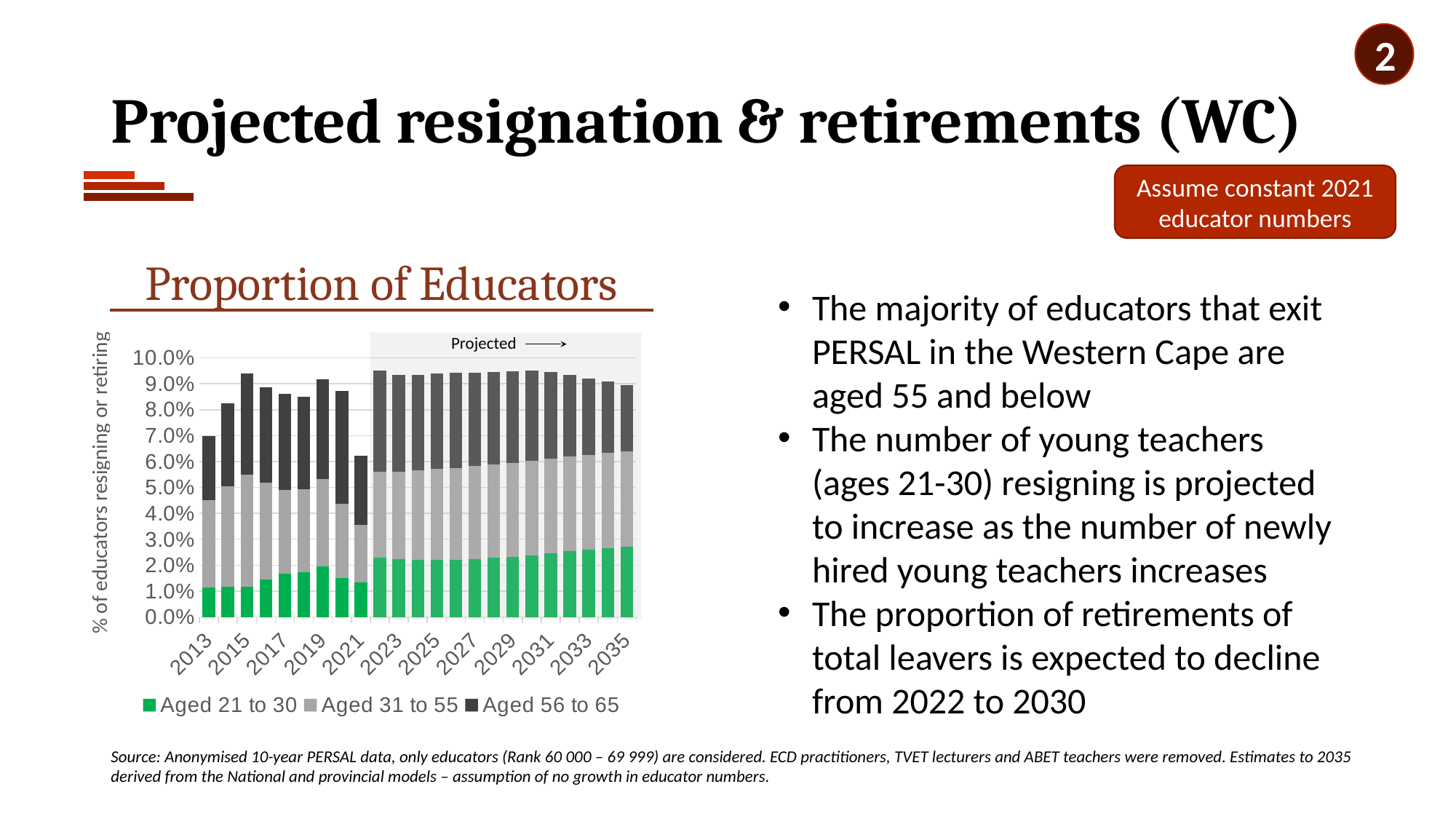
How many series does the chart legend list? 3 Is the total bar for 2013 greater or less than 8.0%? less What is the title of the chart? Proportion of Educators Which year has the lowest total proportion of educators resigning or retiring? 2021 Is the total bar for 2023 greater or less than 9.0%? greater Is the total bar for 2021 greater or less than 7.0%? less What kind of chart is shown on the slide? Stacked bar chart What are the three series listed in the chart legend? Aged 21 to 30, Aged 31 to 55, Aged 56 to 65 How many years (bars) are plotted in the chart? 23 Which year has the larger total bar, 2020 or 2021? 2020 Does the Aged 21 to 30 segment rise or fall from 2022 to 2035? rise